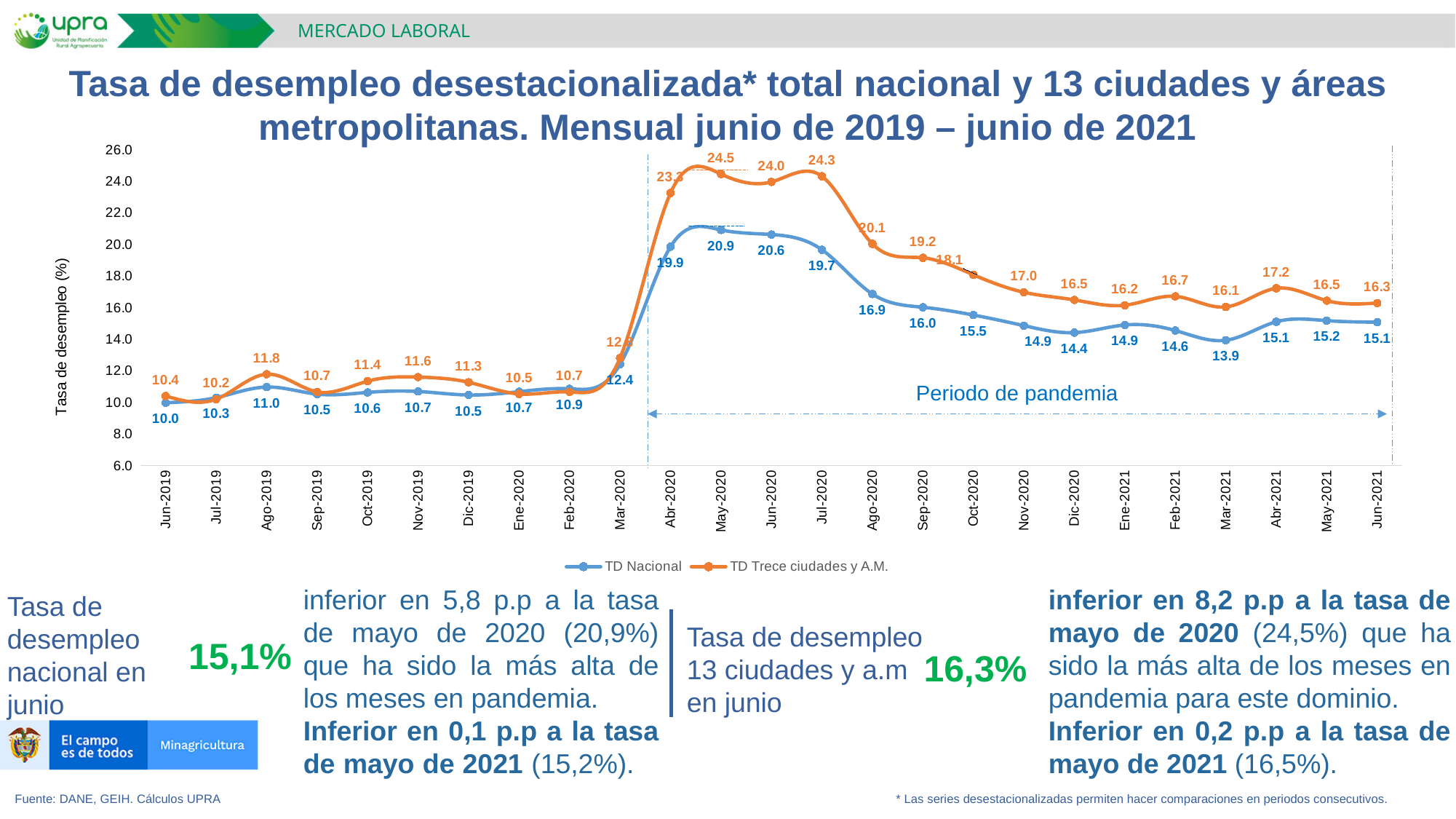
What type of chart is shown on the slide? Line chart How many series does the legend list? 2 In which month does the TD Trece ciudades y A.M. series have its lowest value? Jul-2019 What is the TD Trece ciudades y A.M. value for May-2020? 24.5 Is the TD Nacional value for Ago-2020 greater or less than 18.0? less What is the difference between TD Trece ciudades y A.M. and TD Nacional in Jun-2021? 1.2 In which month does the TD Nacional series reach its highest value? May-2020 What is the TD Nacional value for Jun-2021? 15.1 How many months are plotted on the x axis? 25 What label is written inside the chart above the dashed arrow spanning Abr-2020 to Jun-2021? Periodo de pandemia What is the TD Nacional value for Mar-2021? 13.9 Which series has the higher value in Jul-2020, TD Nacional or TD Trece ciudades y A.M.? TD Trece ciudades y A.M.